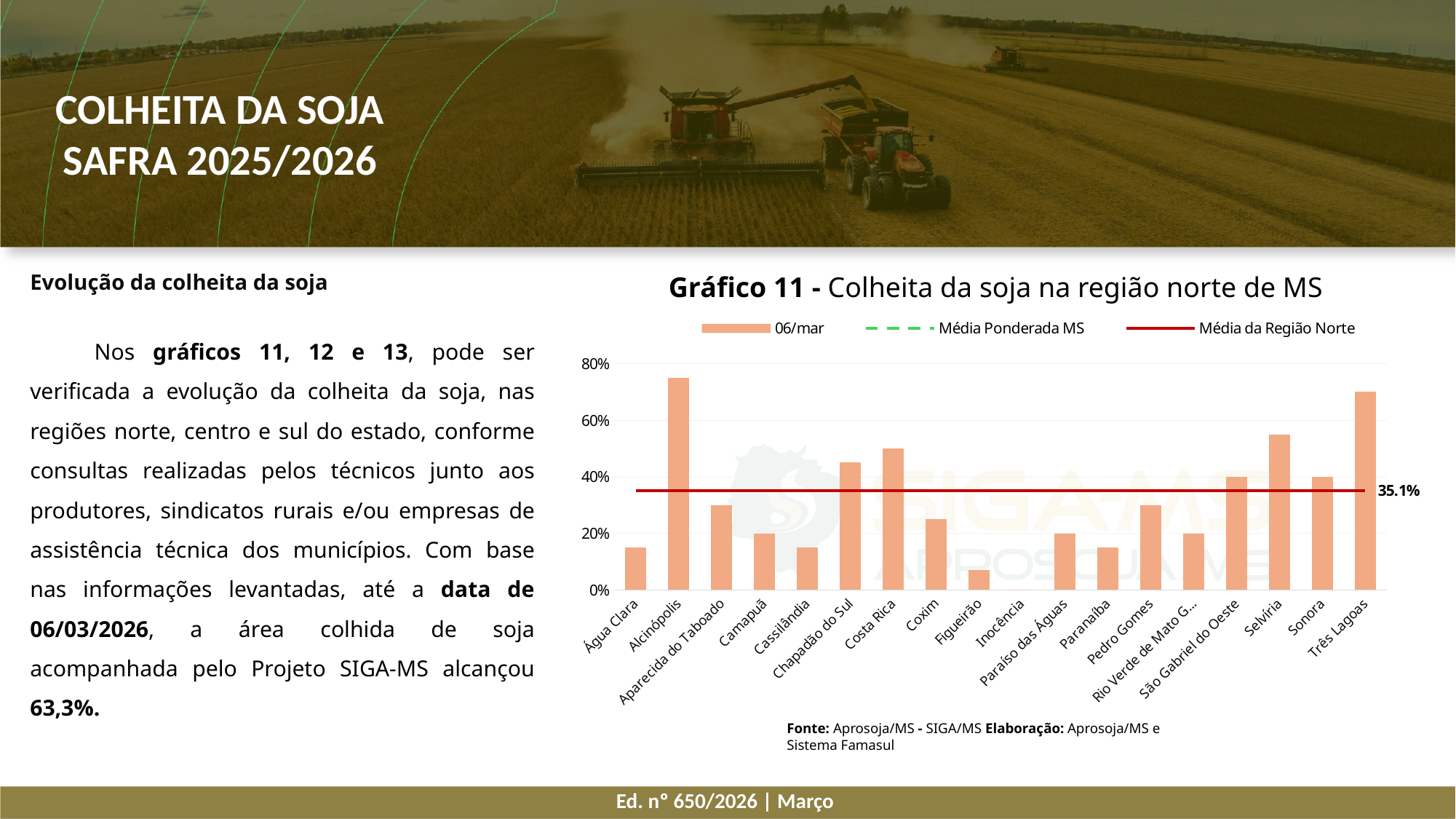
Is the value for Água Clara in Gráfico 11 greater or less than 20%? less In Gráfico 11, which is larger, the value for Costa Rica or the value for Coxim? Costa Rica Is the value for Selvíria in Gráfico 11 greater or less than 40%? greater What value is labelled on the Média da Região Norte line in Gráfico 11? 35.1% Which municipality has the lowest value in Gráfico 11? Inocência Is the value for Figueirão in Gráfico 11 greater or less than 20%? less How many municipalities are shown on the x axis of Gráfico 11? 18 What is the title of the chart on the slide? Gráfico 11 - Colheita da soja na região norte de MS What kind of chart is Gráfico 11? combination bar and line chart How many series does the legend of Gráfico 11 list? 3 Which municipality has the highest bar in Gráfico 11? Alcinópolis